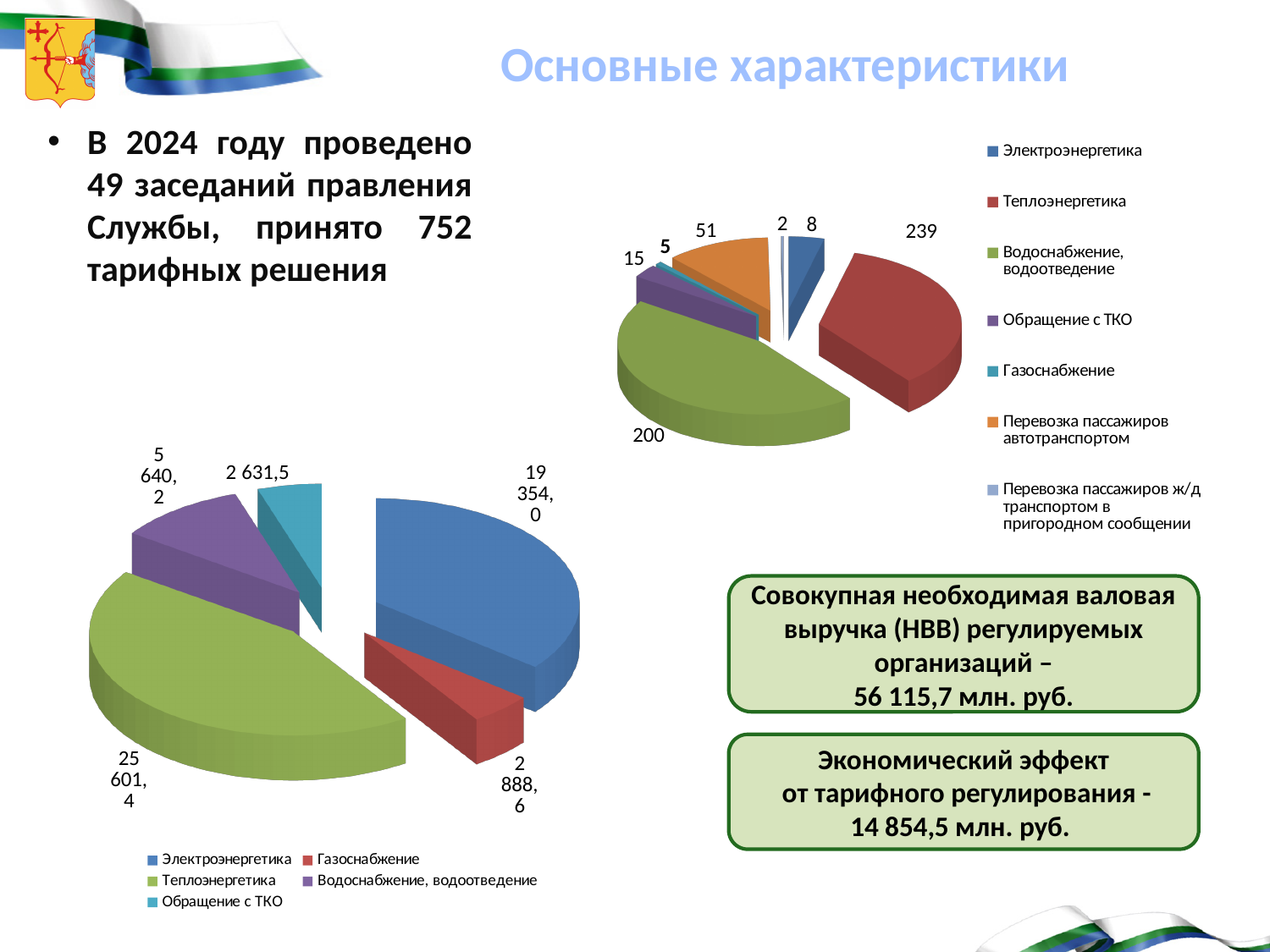
In the top-right pie chart, what is the difference between the values for Теплоэнергетика and Водоснабжение, водоотведение? 39 In the bottom-left pie chart, what is the difference between the values for Водоснабжение, водоотведение and Газоснабжение? 2 751,6 How many categories does the legend of the top-right pie chart list? 7 In the top-right pie chart, what is the value for Теплоэнергетика? 239 In the bottom-left pie chart, what is the value for Теплоэнергетика? 25 601,4 In the bottom-left pie chart, which is larger: Электроэнергетика or Газоснабжение? Электроэнергетика What type of chart is shown at the bottom left of the slide? Pie chart In the top-right pie chart, which category has the largest value? Теплоэнергетика In the bottom-left pie chart, what is the value for Обращение с ТКО? 2 631,5 In the top-right pie chart, which category has the smallest value? Перевозка пассажиров ж/д транспортом в пригородном сообщении In the top-right pie chart, what is the value for Перевозка пассажиров автотранспортом? 51 How many categories does the legend of the bottom-left pie chart list? 5